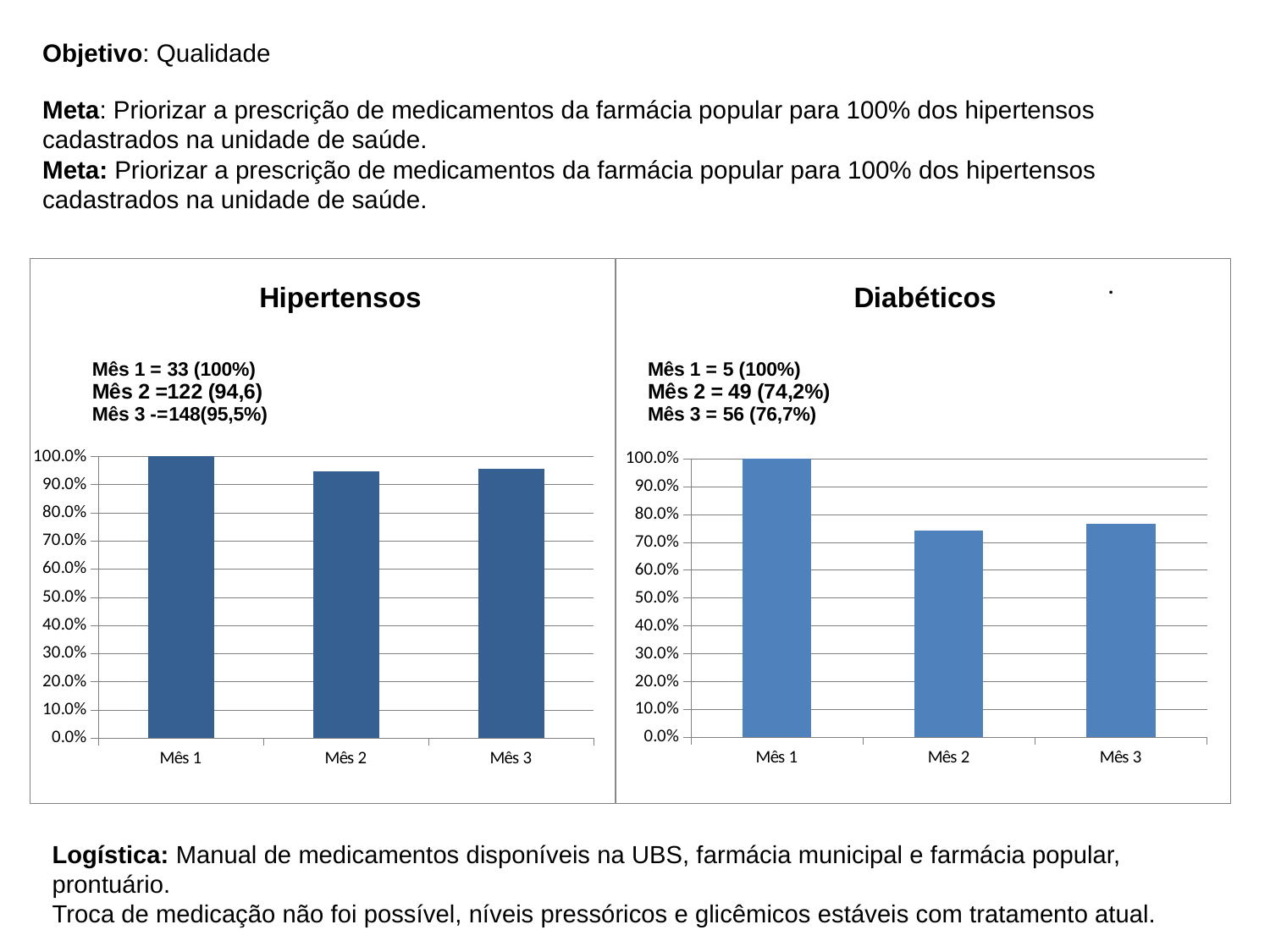
In the Diabéticos chart, what percentage is shown for Mês 3? 76,7% In the Hipertensos chart, which month has the lowest percentage? Mês 2 In the Hipertensos chart, is the value for Mês 3 greater or less than 90.0%? greater In the Diabéticos chart, is the value for Mês 2 greater or less than 80.0%? less How many months are plotted in the Hipertensos chart? 3 What type of chart is the Diabéticos chart? Bar chart In the Hipertensos chart, what percentage is shown for Mês 1? 100% In the Diabéticos chart, is the value for Mês 1 larger or smaller than the value for Mês 3? larger In the Diabéticos chart, what percentage is shown for Mês 2? 74,2% In the Diabéticos chart, which month has the highest percentage? Mês 1 In the Diabéticos chart, which month has the lowest percentage? Mês 2 What is the title of the chart on the left side of the slide? Hipertensos